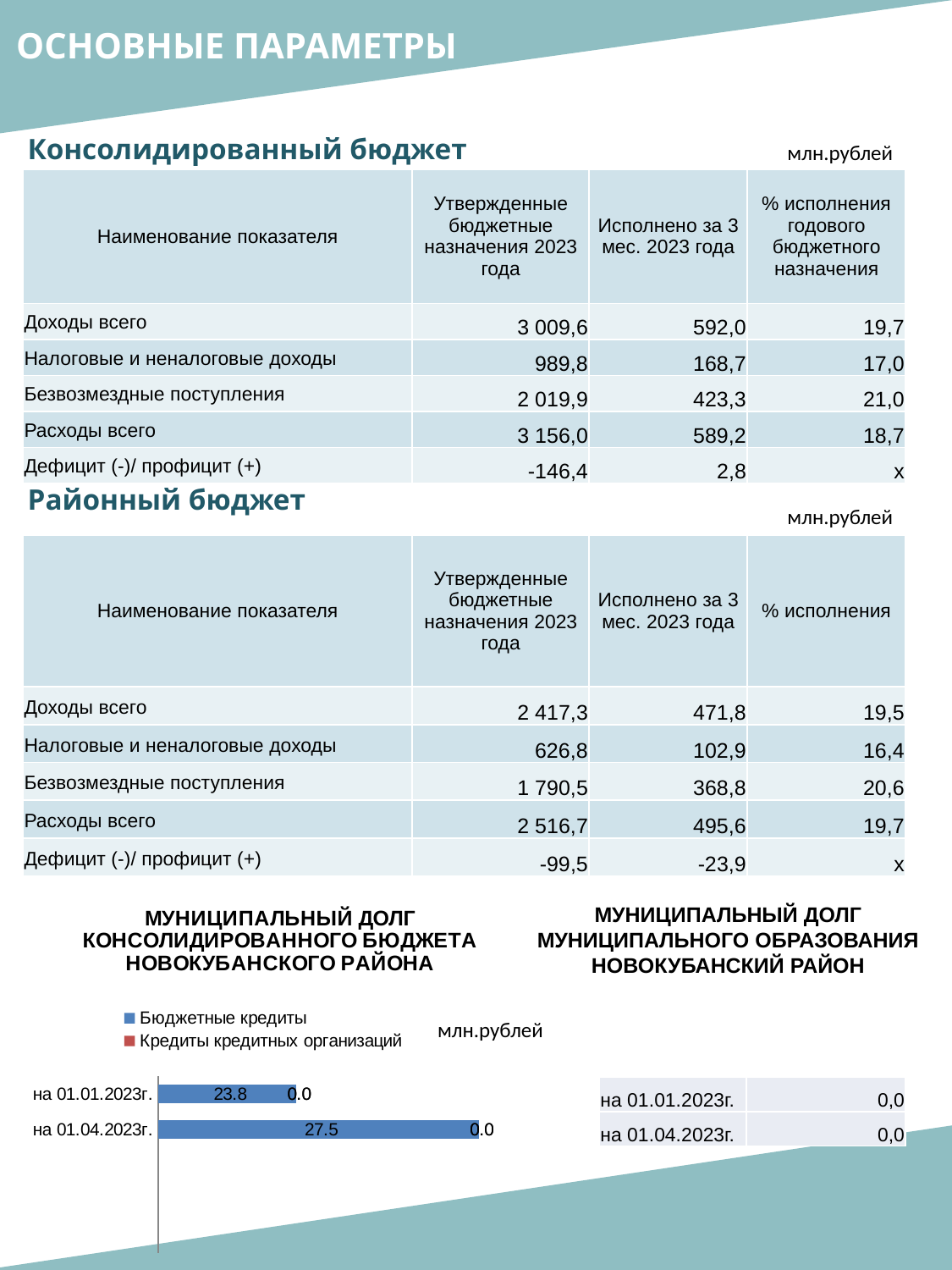
What is the value of Бюджетные кредиты for на 01.01.2023г. in the municipal debt chart? 23.8 What type of chart is the municipal debt chart? bar chart What is the value of Бюджетные кредиты for на 01.04.2023г. in the municipal debt chart? 27.5 In the municipal debt chart, which date has the lower value for Бюджетные кредиты? на 01.01.2023г. What is the value of Кредиты кредитных организаций for на 01.01.2023г. in the municipal debt chart? 0.0 What is the value of Кредиты кредитных организаций for на 01.04.2023г. in the municipal debt chart? 0.0 How many dates (categories) are shown in the municipal debt chart? 2 In the municipal debt chart, is the Бюджетные кредиты value for на 01.04.2023г. larger or smaller than for на 01.01.2023г.? larger In the municipal debt chart, what is the difference between the Бюджетные кредиты values for на 01.04.2023г. and на 01.01.2023г.? 3.7 In the municipal debt chart, which date has the higher value for Бюджетные кредиты? на 01.04.2023г. How many series does the legend of the municipal debt chart list? 2 What unit is indicated next to the legend of the municipal debt chart? млн.рублей